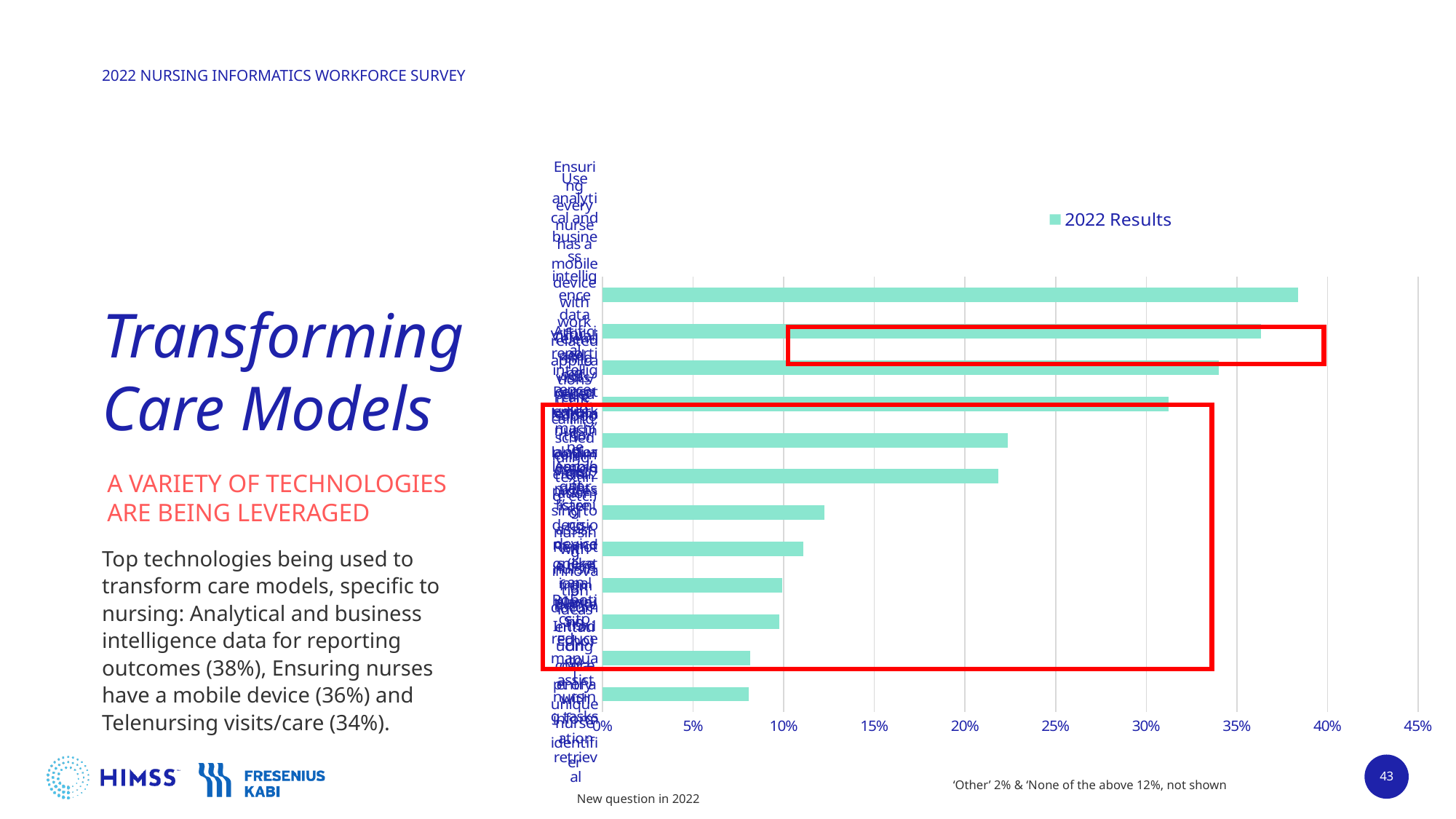
How many bars are plotted in the chart? 12 Do the bar values increase or decrease going from the top of the chart to the bottom? decrease How many series does the chart legend list? 1 Is the value of the bottom bar in the chart greater or less than 10%? less Is the value of the topmost bar in the chart greater or less than 35%? greater Which bar has the largest value: the topmost bar or the bottom bar? the topmost bar Is the value of the fifth bar from the top greater or less than 20%? greater What is the name of the series shown in the chart legend? 2022 Results Which bar in the chart has the highest value, by position? the topmost bar What is the highest value shown on the chart's percentage axis? 45% What kind of chart is shown on the slide? bar chart